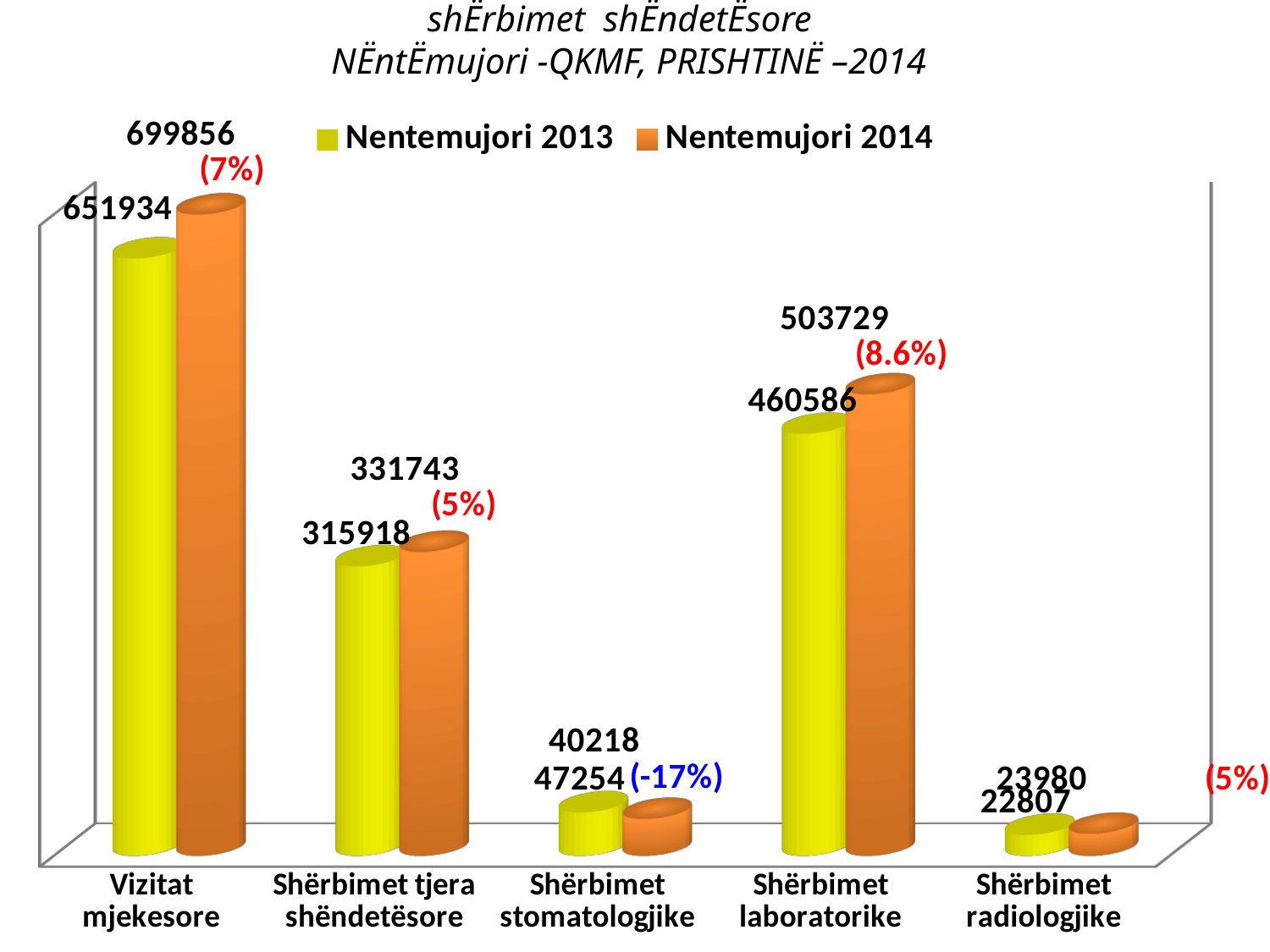
Which category has the lowest value in the Nentemujori 2013 series? Shërbimet radiologjike What is the value for Vizitat mjekesore in the Nentemujori 2014 series? 699856 What kind of chart is shown on the slide? Bar chart How many series does the legend list? 2 What is the value for Shërbimet radiologjike in the Nentemujori 2013 series? 22807 What is the value for Shërbimet laboratorike in the Nentemujori 2013 series? 460586 Which category has the highest value in the Nentemujori 2014 series? Vizitat mjekesore What is the difference between the Nentemujori 2014 and Nentemujori 2013 values for Shërbimet laboratorike? 43143 How many categories are shown on the x axis? 5 For Shërbimet stomatologjike, which series has the larger value, Nentemujori 2013 or Nentemujori 2014? Nentemujori 2013 What percentage change is shown next to the Shërbimet laboratorike bars? 8.6% What is the value for Shërbimet stomatologjike in the Nentemujori 2014 series? 40218